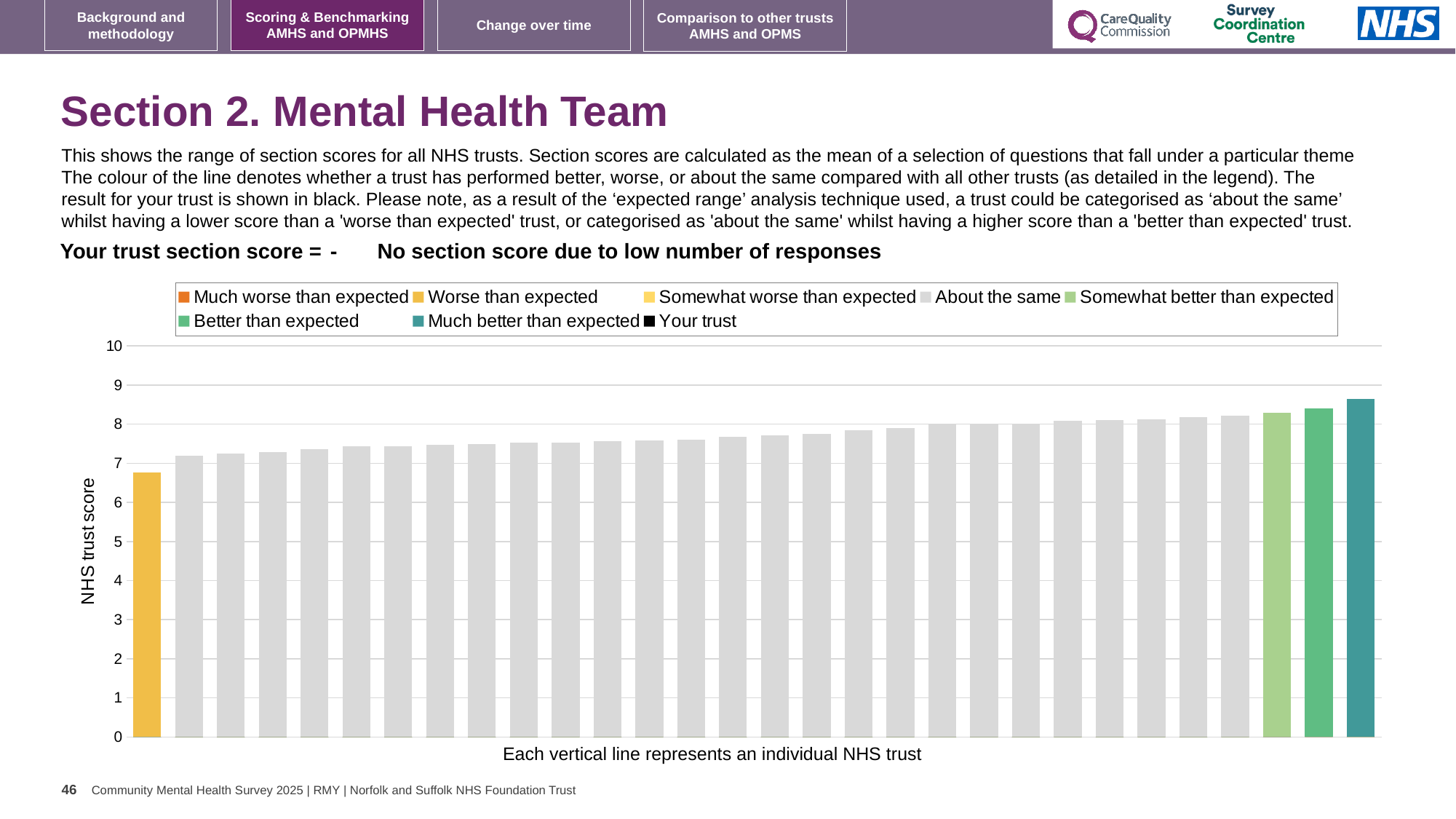
Is the value of the rightmost (teal) bar greater or less than 8? greater What is the maximum value shown on the y axis? 10 How many bars (NHS trusts) are plotted in the chart? 30 What kind of chart is shown on the slide? Bar chart According to the legend, what does the black colour represent? Your trust Is the value of the leftmost (yellow) bar greater or less than 7? less How many bars are shown in a green or teal colour (better than expected categories)? 3 Which bar has the highest value: the leftmost or the rightmost? rightmost Do the bar values rise or fall moving from left to right along the x axis? rise How many entries does the chart legend list? 8 Is the value of the second bar from the left greater or less than 8? less What is the label on the y axis of the chart? NHS trust score